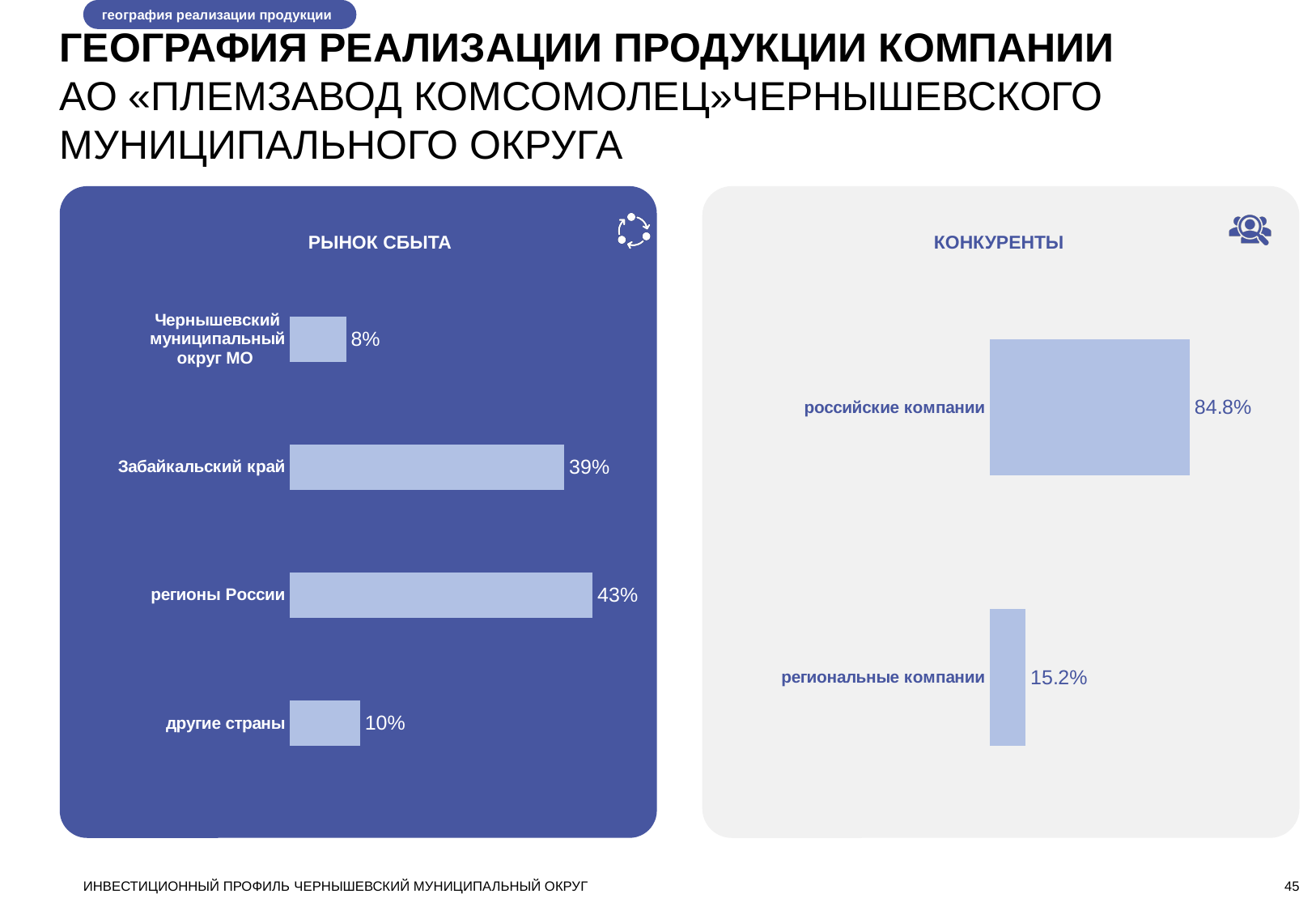
In the 'КОНКУРЕНТЫ' chart, what is the difference between 'российские компании' and 'региональные компании'? 69.6% In the 'РЫНОК СБЫТА' chart, which is larger: 'Забайкальский край' or 'другие страны'? Забайкальский край In the 'РЫНОК СБЫТА' chart, what is the difference between 'регионы России' and 'другие страны'? 33% In the 'РЫНОК СБЫТА' chart, which category has the lowest value? Чернышевский муниципальный округ МО What kind of chart is the 'РЫНОК СБЫТА' chart? bar chart In the 'КОНКУРЕНТЫ' chart, what is the value for 'региональные компании'? 15.2% In the 'РЫНОК СБЫТА' chart, which category has the highest value? регионы России In the 'КОНКУРЕНТЫ' chart, what is the value for 'российские компании'? 84.8% In the 'РЫНОК СБЫТА' chart, what is the value for 'Забайкальский край'? 39% How many categories are shown in the 'РЫНОК СБЫТА' chart? 4 In the 'РЫНОК СБЫТА' chart, what is the value for 'Чернышевский муниципальный округ МО'? 8% How many categories are shown in the 'КОНКУРЕНТЫ' chart? 2